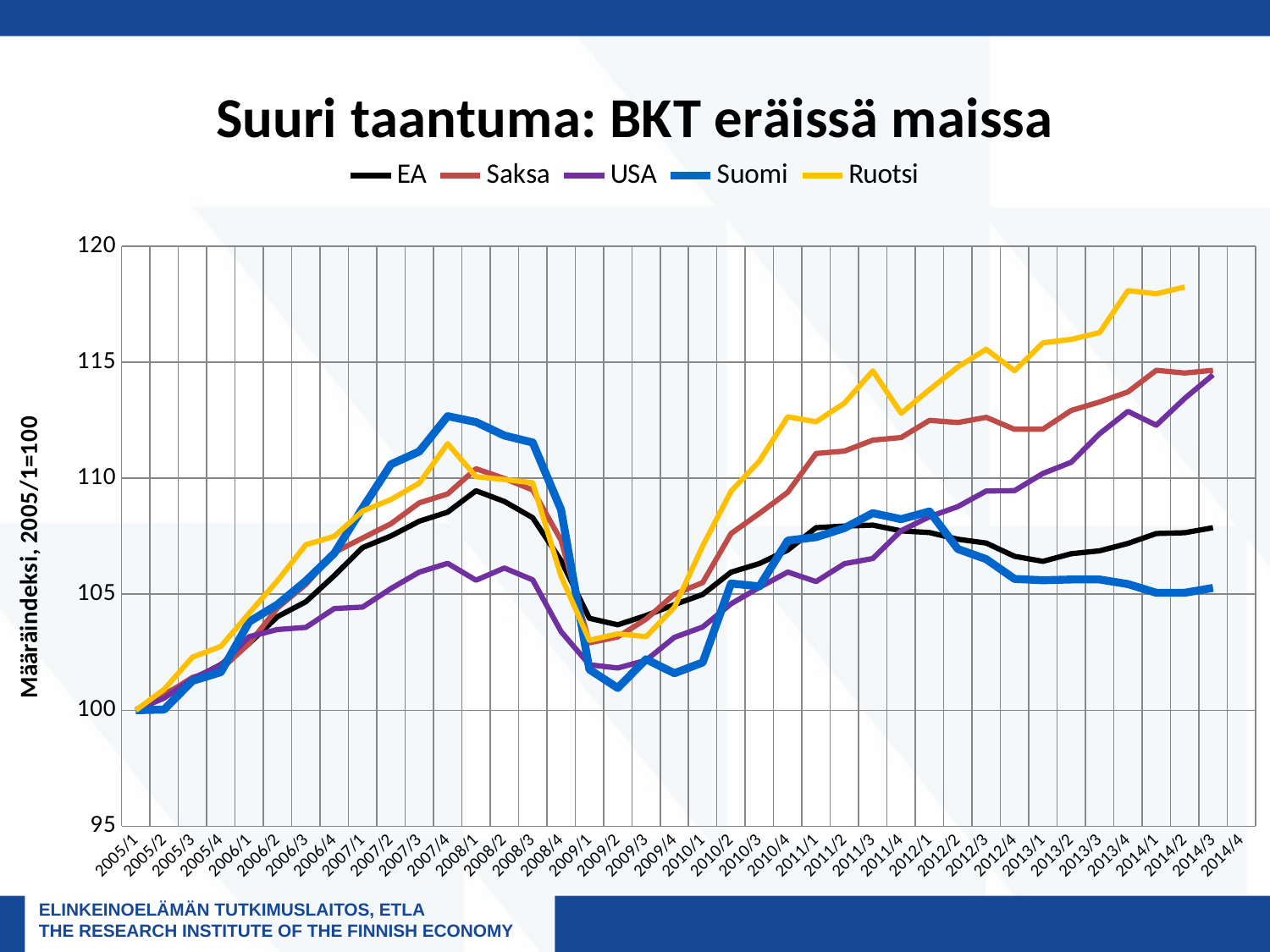
Which series has the lowest value at 2014/3? Suomi Is the value for Suomi at 2009/2 greater or less than 105? less At 2014/3, which is larger, Saksa or EA? Saksa At 2007/4, which is larger, Suomi or USA? Suomi What kind of chart is shown on the slide? line chart What is the title of the chart? Suuri taantuma: BKT eräissä maissa What is the label on the vertical axis? Määräindeksi, 2005/1=100 How many series does the legend list? 5 What is the value of the Suomi series at 2005/1? 100 Is the value for Suomi at 2014/3 greater or less than 110? less